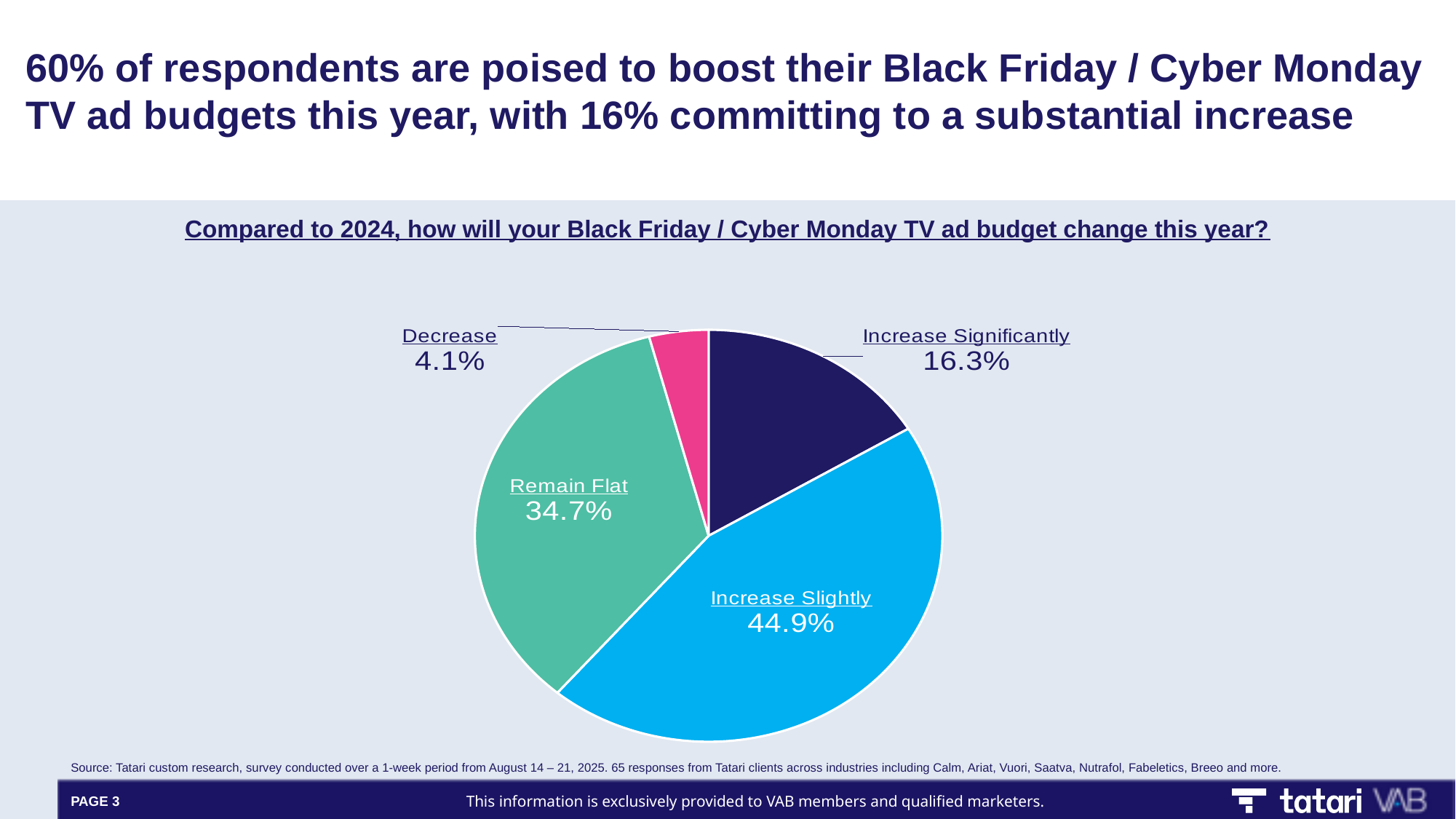
How many slices does the pie chart have? 4 What percentage of respondents said their budget will Increase Significantly? 16.3% What percentage of respondents said their budget will Decrease? 4.1% What is the title of the chart? Compared to 2024, how will your Black Friday / Cyber Monday TV ad budget change this year? What kind of chart is shown on the slide? Pie chart What percentage of respondents said their budget will Increase Slightly? 44.9% What is the combined share of Increase Significantly and Increase Slightly? 61.2% Which is larger, the share for Increase Significantly or the share for Decrease? Increase Significantly What percentage of respondents said their budget will Remain Flat? 34.7% Which response has the largest share of the pie? Increase Slightly Which response has the smallest share of the pie? Decrease What is the difference in percentage points between Increase Slightly and Remain Flat? 10.2